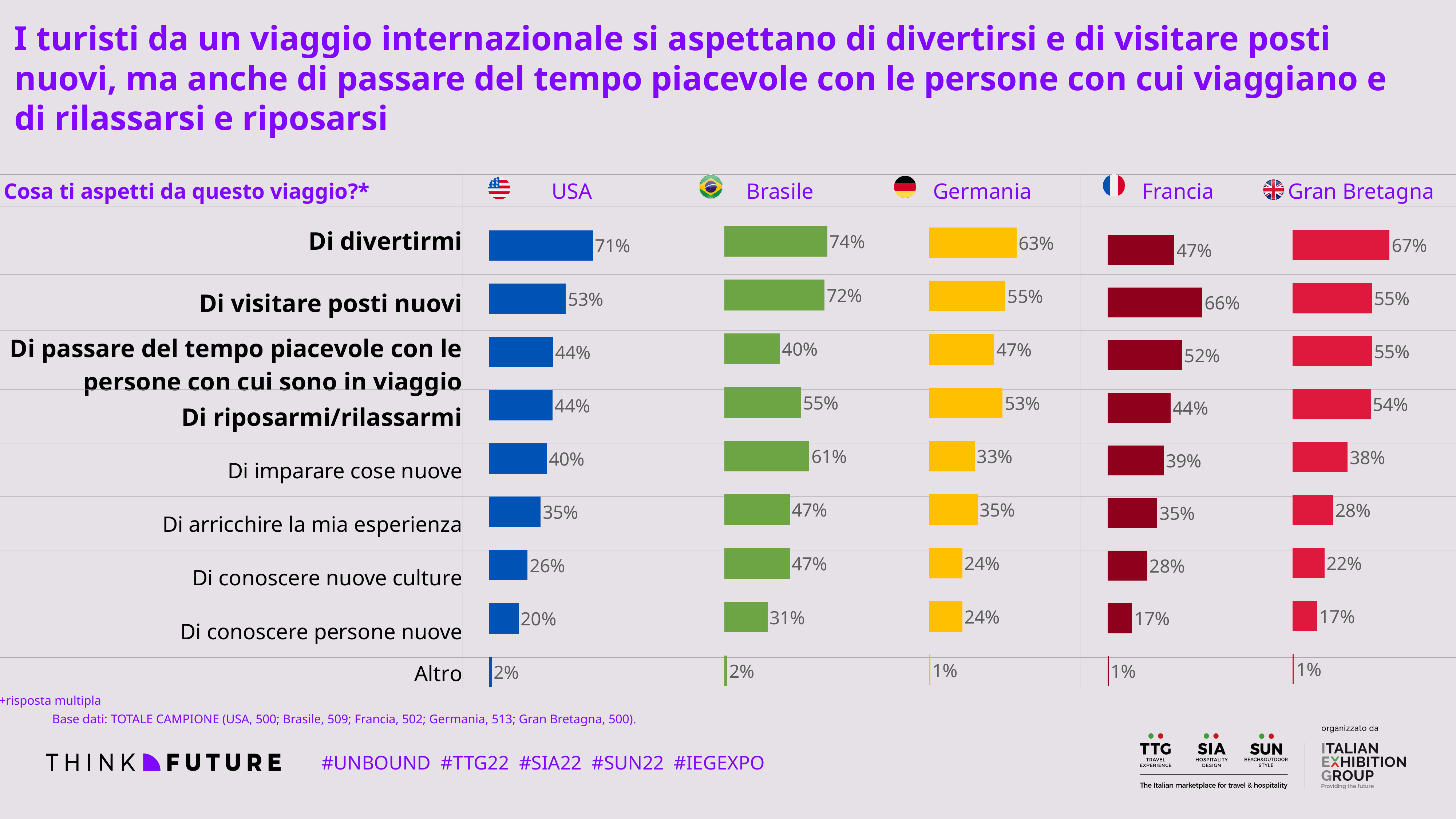
In the Francia chart, which category has the highest value? Di visitare posti nuovi In the Germania chart, which category has the highest value? Di divertirmi In the Gran Bretagna chart, what is the value for "Di conoscere nuove culture"? 22% In the USA chart, what is the value for "Di divertirmi"? 71% In the Gran Bretagna chart, which is larger: "Di divertirmi" or "Di riposarmi/rilassarmi"? Di divertirmi How many categories does each country's chart show? 9 In the Brasile chart, what is the difference between "Di divertirmi" and "Di conoscere persone nuove"? 43% In the Germania chart, what is the difference between "Di visitare posti nuovi" and "Di imparare cose nuove"? 22% In the Francia chart, what is the value for "Di visitare posti nuovi"? 66% In the USA chart, which category has the lowest value? Altro What kind of chart is used for each country on the slide? Bar chart In the Brasile chart, what is the value for "Di imparare cose nuove"? 61%